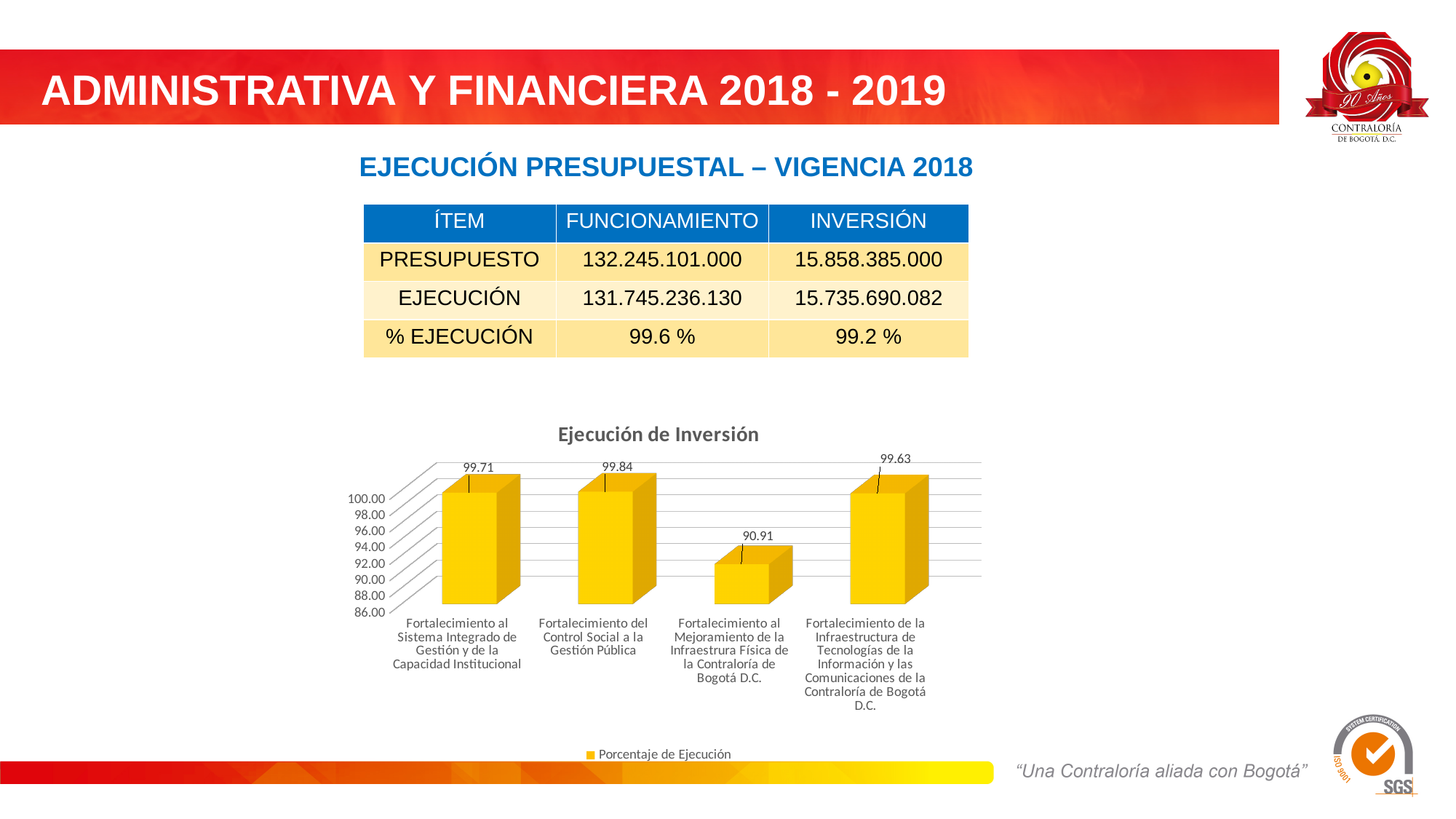
What kind of chart is the Ejecución de Inversión chart? bar chart What is the value for Fortalecimiento al Mejoramiento de la Infraestrura Física de la Contraloría de Bogotá D.C. in the Ejecución de Inversión chart? 90.91 In the Ejecución de Inversión chart, is the value for Fortalecimiento al Mejoramiento de la Infraestrura Física de la Contraloría de Bogotá D.C. greater or less than 94.00? less Which category has the lowest value in the Ejecución de Inversión chart? Fortalecimiento al Mejoramiento de la Infraestrura Física de la Contraloría de Bogotá D.C. Which category has the highest value in the Ejecución de Inversión chart? Fortalecimiento del Control Social a la Gestión Pública How many categories are shown in the Ejecución de Inversión chart? 4 What is the value for Fortalecimiento de la Infraestructura de Tecnologías de la Información y las Comunicaciones de la Contraloría de Bogotá D.C. in the Ejecución de Inversión chart? 99.63 In the Ejecución de Inversión chart, what is the difference between the value for Fortalecimiento del Control Social a la Gestión Pública and the value for Fortalecimiento al Mejoramiento de la Infraestrura Física de la Contraloría de Bogotá D.C.? 8.93 What is the value for Fortalecimiento del Control Social a la Gestión Pública in the Ejecución de Inversión chart? 99.84 What is the value for Fortalecimiento al Sistema Integrado de Gestión y de la Capacidad Institucional in the Ejecución de Inversión chart? 99.71 In the Ejecución de Inversión chart, which is larger: the value for Fortalecimiento al Sistema Integrado de Gestión y de la Capacidad Institucional or the value for Fortalecimiento al Mejoramiento de la Infraestrura Física de la Contraloría de Bogotá D.C.? Fortalecimiento al Sistema Integrado de Gestión y de la Capacidad Institucional What series name does the legend of the Ejecución de Inversión chart show? Porcentaje de Ejecución